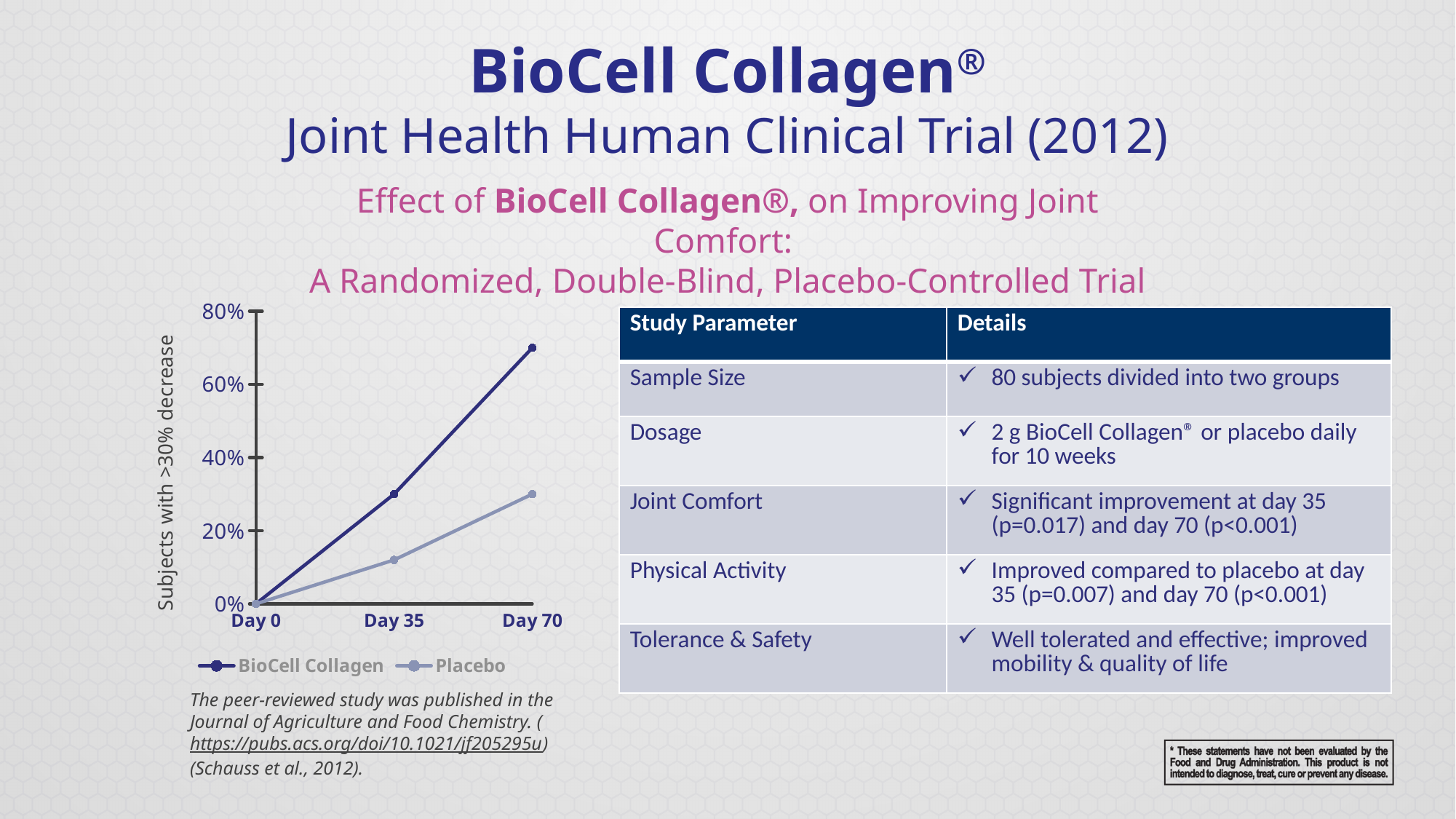
At Day 70, which series has the higher value, BioCell Collagen or Placebo? BioCell Collagen Is the value for Placebo at Day 70 greater or less than 40%? less Do the values for the Placebo series rise or fall from Day 0 to Day 70? rise What is the value for Placebo at Day 0? 0% What is the label on the y axis of the chart? Subjects with >30% decrease At which time point does the BioCell Collagen series reach its highest value? Day 70 How many series does the chart legend list? 2 Is the value for Placebo at Day 35 greater or less than 20%? less What is the value for BioCell Collagen at Day 0? 0% How many time points are plotted along the x axis of the chart? 3 Is the value for BioCell Collagen at Day 70 greater or less than 60%? greater What kind of chart is shown on the slide? line chart